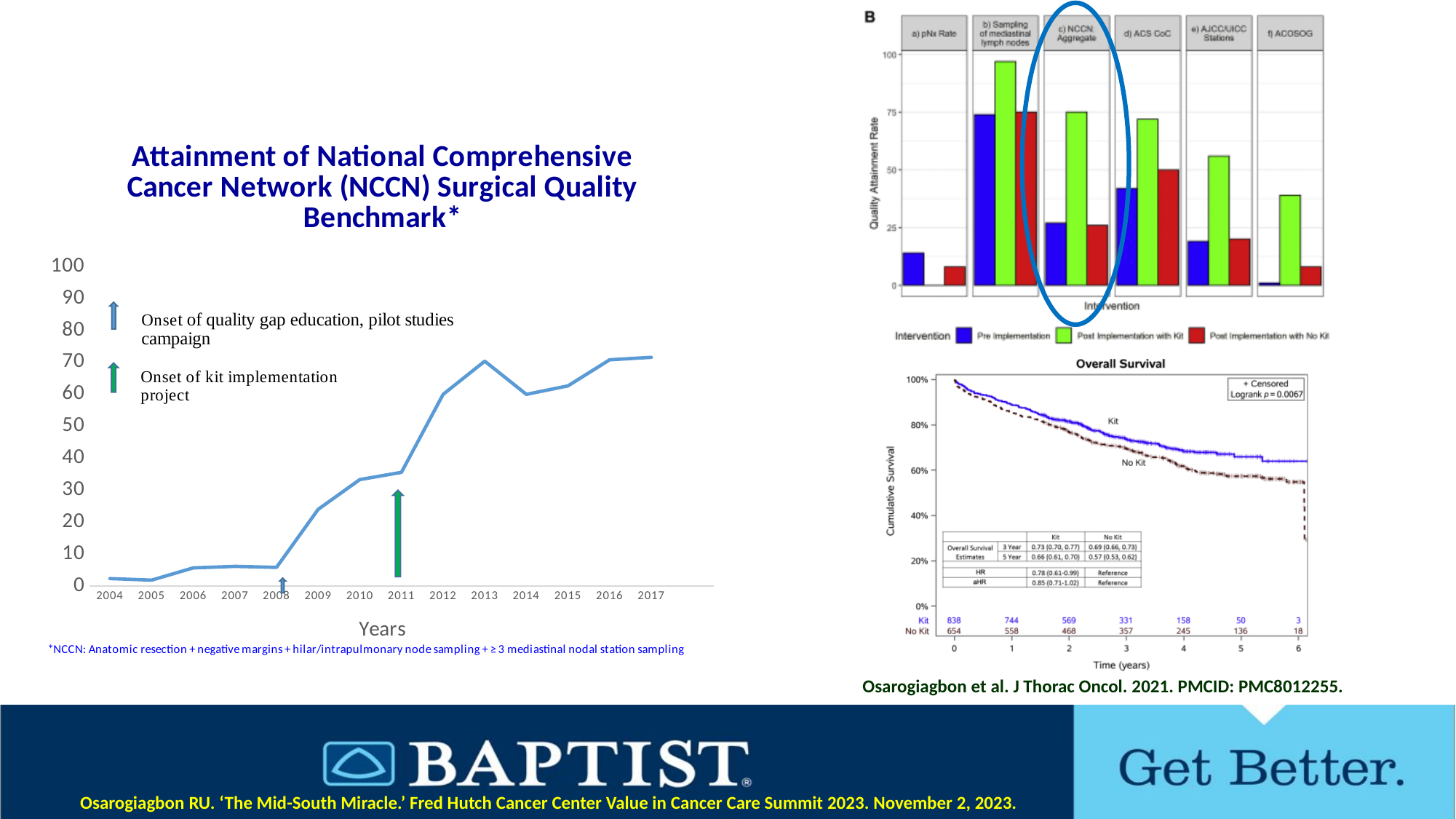
In the top-right bar chart (panel B, Quality Attainment Rate), how many series does the legend list? 3 In the NCCN Surgical Quality Benchmark line chart, do the values generally rise or fall from 2004 to 2017? Rise In the NCCN Surgical Quality Benchmark line chart, what is the x-axis title? Years In the NCCN Surgical Quality Benchmark line chart, which year has the larger value, 2009 or 2012? 2012 In the top-right bar chart (panel B, Quality Attainment Rate), which intervention has the higher Pre Implementation bar, 'a) pNx Rate' or 'd) ACS CoC'? d) ACS CoC In the 'Overall Survival' chart, what is the number at risk in the Kit group at time 0 years? 838 In the NCCN Surgical Quality Benchmark line chart, is the value for 2010 greater or less than 30? greater In the top-right bar chart (panel B, Quality Attainment Rate), is the Post Implementation with Kit value for 'b) Sampling of mediastinal lymph nodes' greater or less than 75? greater What kind of chart is the 'Attainment of National Comprehensive Cancer Network (NCCN) Surgical Quality Benchmark' chart on the left of the slide? Line chart In the NCCN Surgical Quality Benchmark line chart, is the value for 2008 greater or less than 10? less In the NCCN Surgical Quality Benchmark line chart, how many years are plotted along the x axis? 14